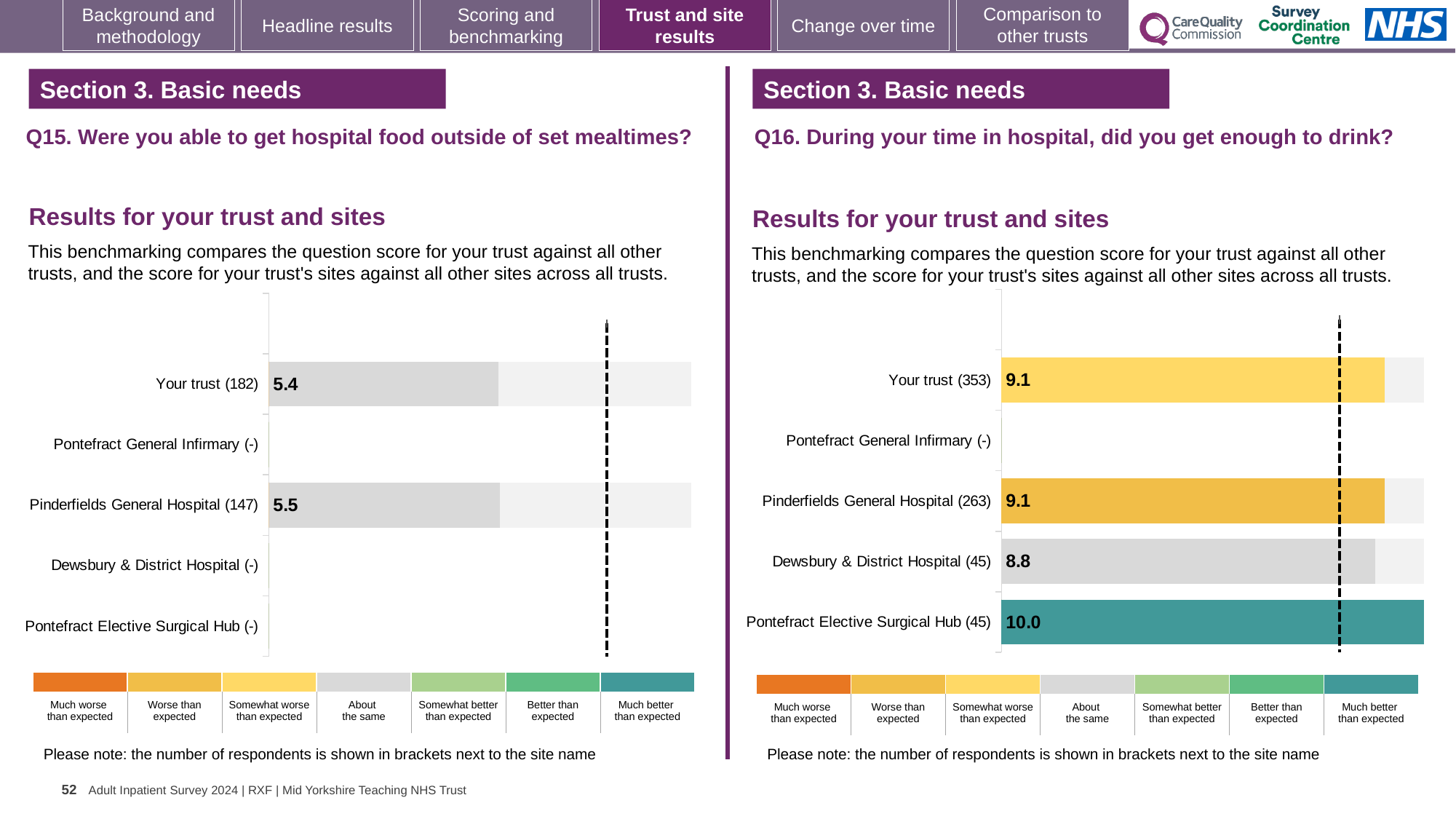
On the Q16 chart (right), what is the score for Pontefract Elective Surgical Hub (45)? 10.0 On the Q15 chart (left), what is the score for Pinderfields General Hospital (147)? 5.5 On the Q15 chart (left), what is the difference between the scores for Pinderfields General Hospital and Your trust? 0.1 On the Q16 chart (right), which site has the highest score? Pontefract Elective Surgical Hub On the Q16 chart (right), what is the difference between the scores for Pontefract Elective Surgical Hub and Dewsbury & District Hospital? 1.2 On the Q16 chart (right), what is the score for Dewsbury & District Hospital (45)? 8.8 On the Q15 chart (left), how many site or trust categories are listed on the vertical axis? 5 On the Q16 chart (right), which site with a plotted score has the lowest score? Dewsbury & District Hospital On the Q15 chart (left), what is the score for Your trust (182)? 5.4 On the Q16 chart (right), what is the score for Your trust (353)? 9.1 What type of chart is used on the Q16 chart (right)? Bar chart On the Q16 chart (right), which benchmark category does the colour of the Pontefract Elective Surgical Hub bar correspond to in the key? Much better than expected